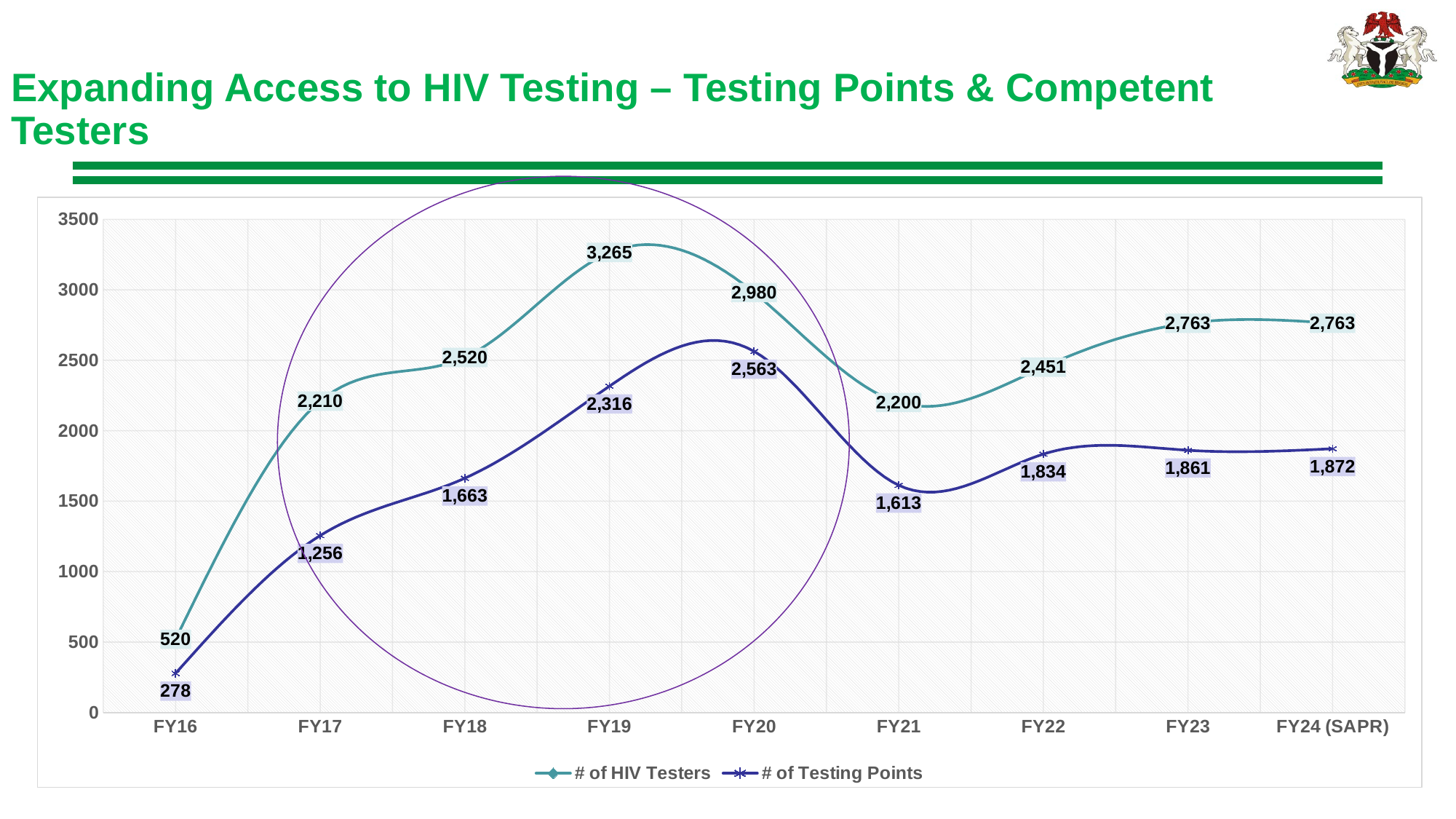
How many series does the legend list? 2 How many fiscal years are shown on the x axis? 9 What is the number of HIV Testers in FY19? 3,265 By how much did the number of HIV Testers change from FY20 to FY21? 780 Does the number of Testing Points rise or fall from FY16 to FY20? Rise What kind of chart is shown on the slide? Line chart What is the difference between the number of HIV Testers and the number of Testing Points in FY20? 417 In which fiscal year is the number of Testing Points lowest? FY16 What is the number of Testing Points in FY16? 278 In which fiscal year is the number of HIV Testers highest? FY19 Which is larger in FY21: the number of HIV Testers or the number of Testing Points? # of HIV Testers What is the number of Testing Points in FY24 (SAPR)? 1,872